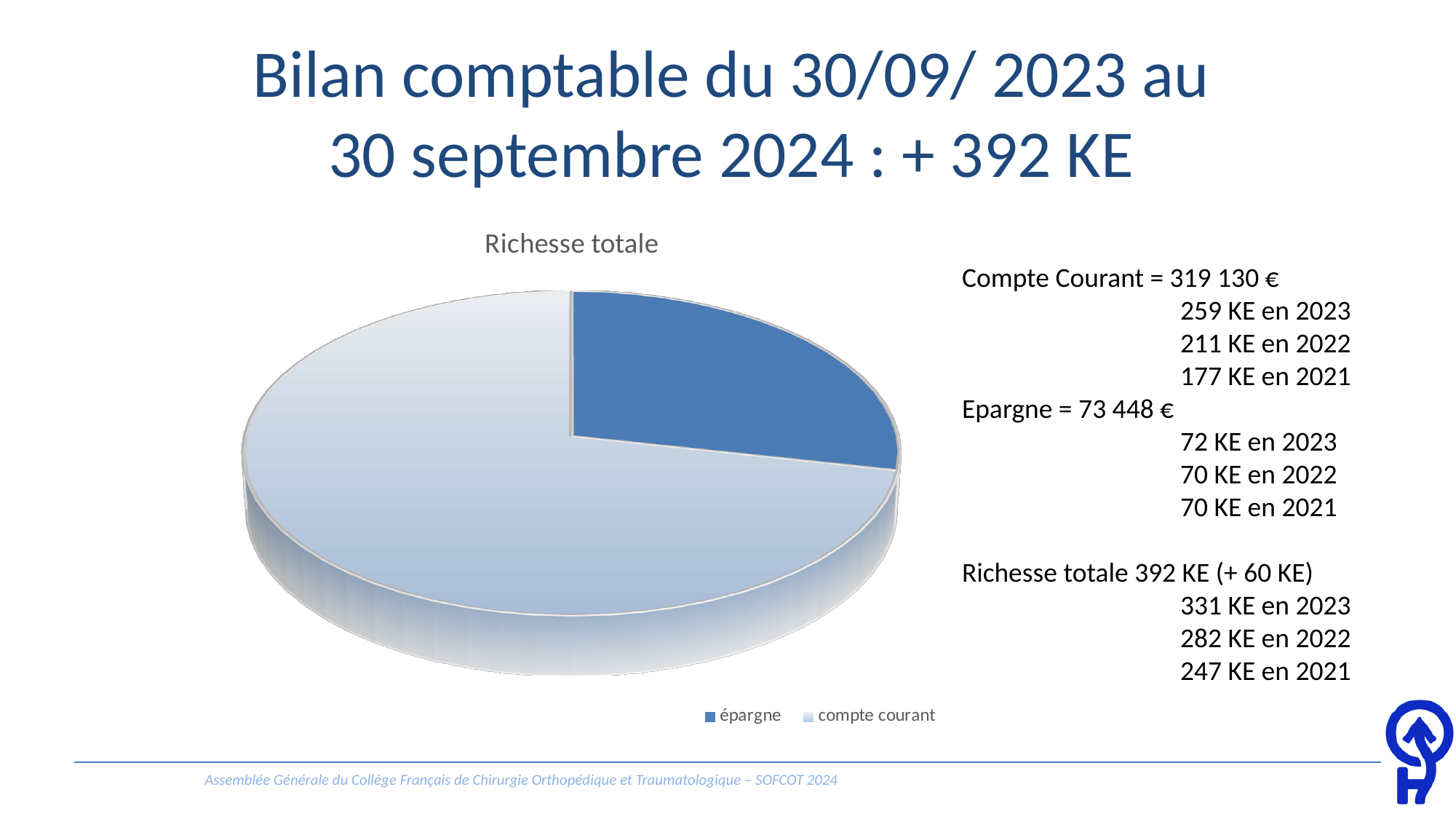
What kind of chart is shown on the slide? pie chart What colour is the épargne slice in the pie chart? dark blue Which slice of the pie chart is the largest? compte courant What is the value of the compte courant shown on the slide? 319 130 € What is the difference between the compte courant (319 130 €) and the épargne (73 448 €)? 245 682 € How many entries does the legend of the pie chart list? 2 How many slices does the pie chart have? 2 What is the title of the pie chart? Richesse totale Does the épargne slice take up more or less than half of the pie? less Which is larger in the pie chart, épargne or compte courant? compte courant Which slice of the pie chart is the smallest? épargne What is the value of the épargne shown on the slide? 73 448 €